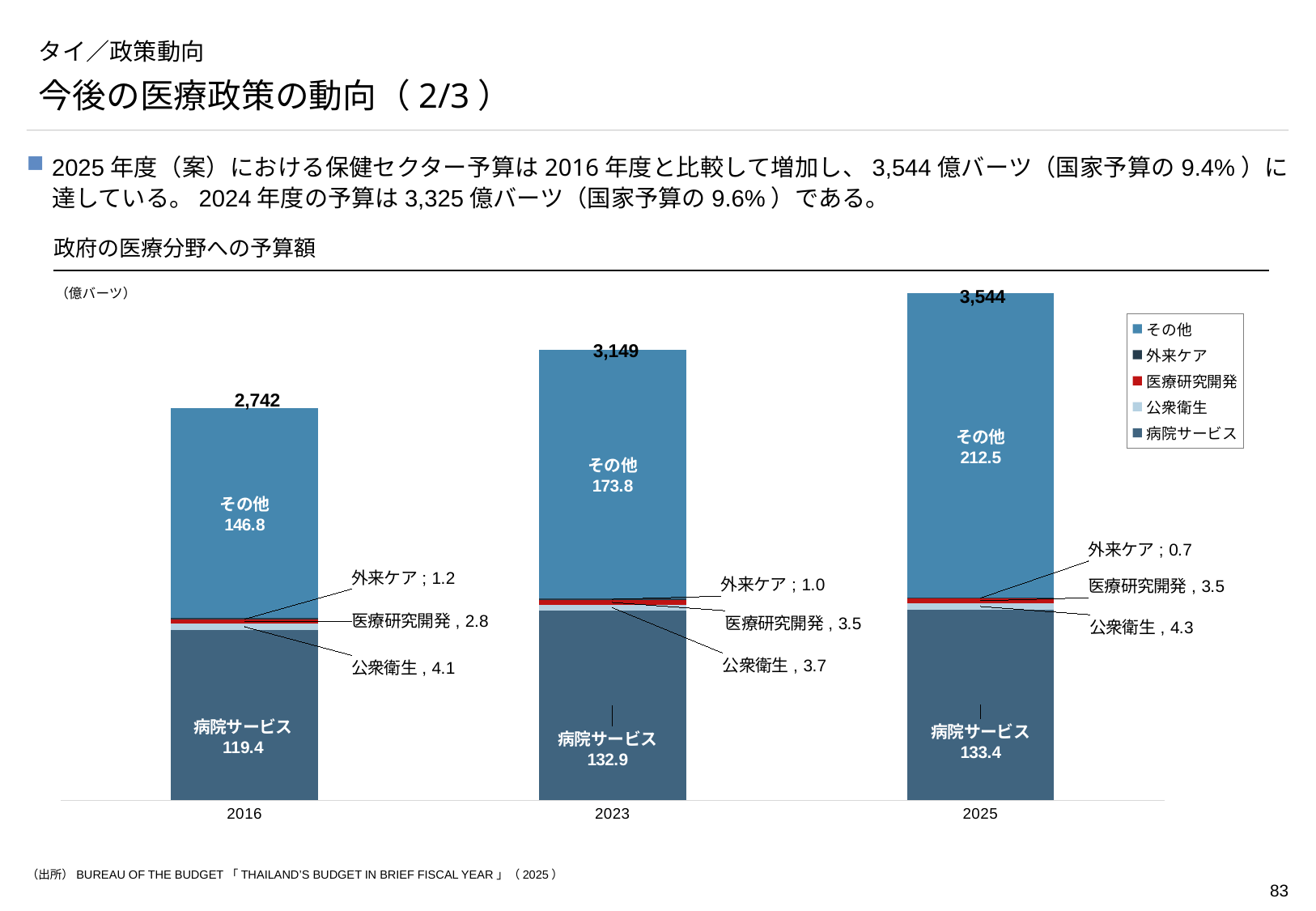
Do the total values printed above the bars rise or fall from 2016 to 2025? rise What is the value of 外来ケア in 2025? 0.7 What is the difference between the その他 values for 2025 and 2016? 65.7 What is the total value printed above the bar for 2025? 3,544 What is the value of その他 in 2025? 212.5 How many years (categories) are shown on the x axis of the chart? 3 What is the total value printed above the bar for 2016? 2,742 How many series does the legend of the chart list? 5 Which year has the highest total value printed above its bar? 2025 What is the value of 病院サービス in 2023? 132.9 What is the value of 公衆衛生 in 2016? 4.1 What type of chart is shown on the slide? stacked bar chart